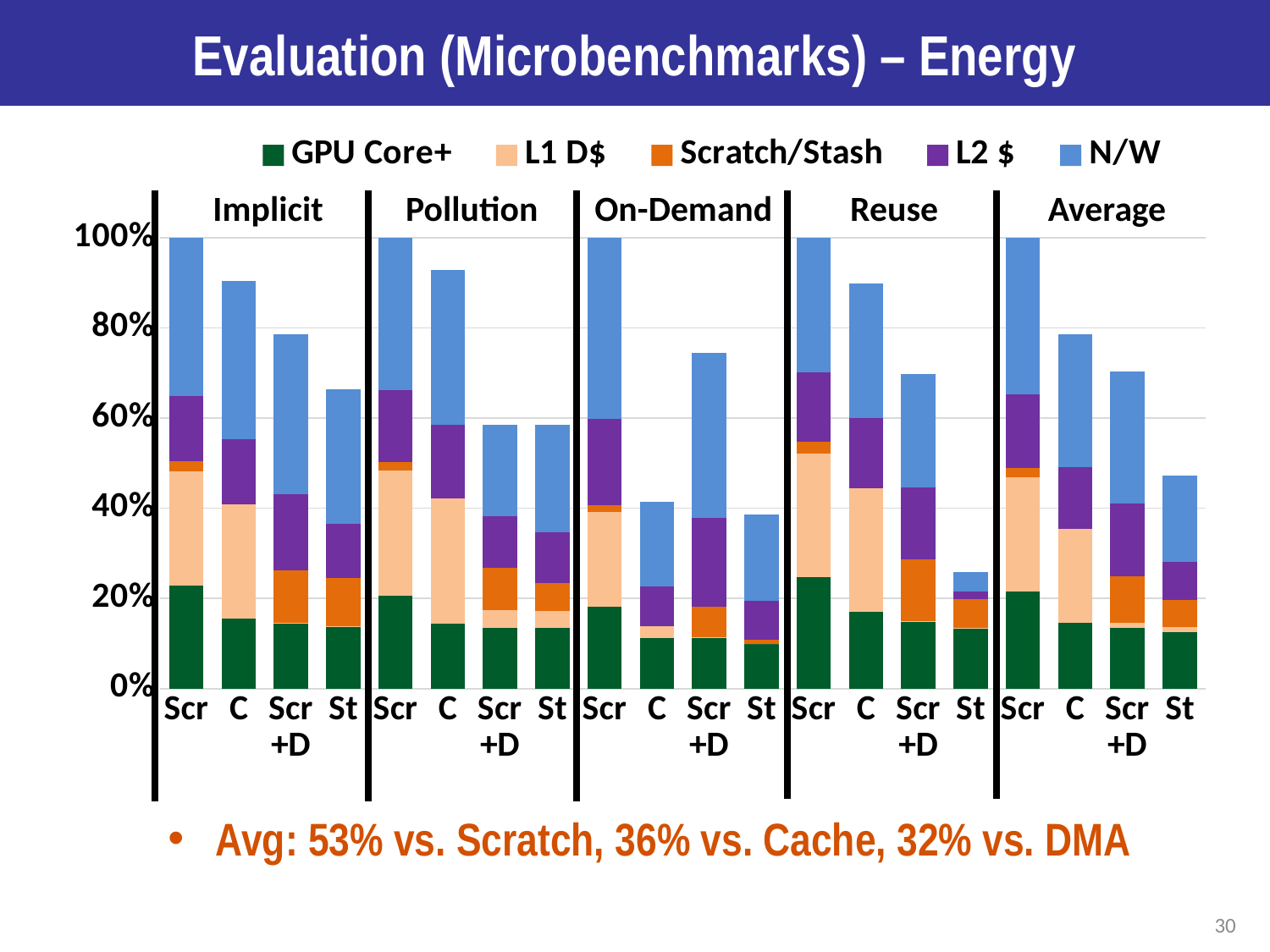
Which bar in the Reuse group is the highest? Scr How many series does the legend list? 5 How many bars are plotted in the Average group? 4 What is the total height of the Scr bar in the Implicit group? 100% How many benchmark groups are shown along the x axis? 5 Which bar in the Average group is the lowest? St What kind of chart is shown on the slide? Stacked bar chart Is the total for the Scr+D bar in the On-Demand group greater or less than 60%? greater Is the total for the St bar in the Reuse group greater or less than 40%? less Do the bar totals rise or fall from Scr to St within the Average group? fall Which is larger, the C bar in the Pollution group or the C bar in the On-Demand group? C in Pollution Which series is shown in dark green in the legend? GPU Core+